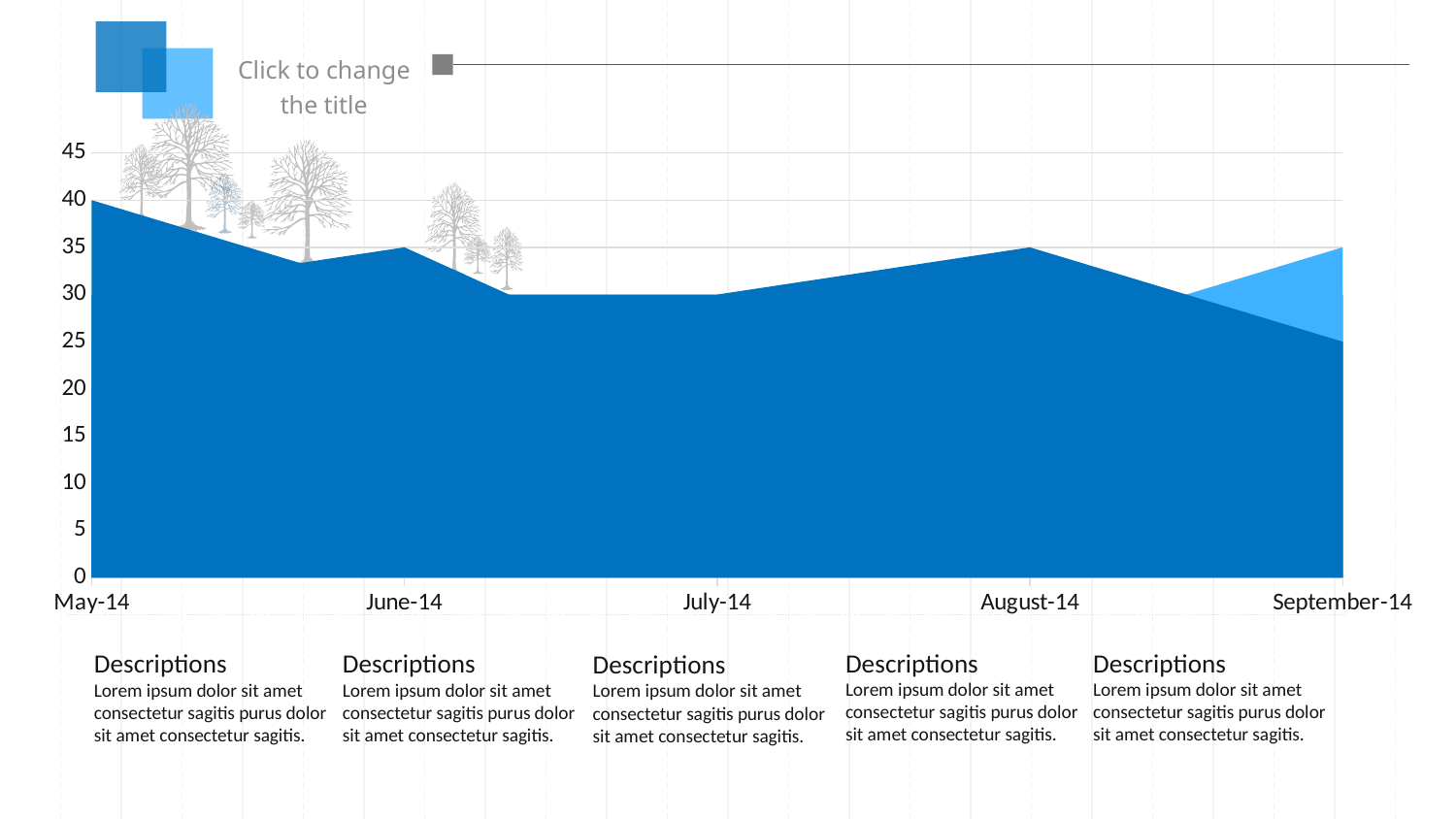
Is the value for May-14 greater or less than 35? greater Do the values rise or fall from May-14 to July-14? fall Is the value for August-14 greater or less than 30? greater Which is larger, the value for May-14 or the value for July-14? May-14 Is the value for June-14 greater or less than 40? less What kind of chart is shown on the slide? area chart Which month has the highest value in the chart? May-14 What is the title shown above the chart? Click to change the title Which month has the lowest value for the dark blue area? September-14 How many month labels are shown on the x axis of the chart? 5